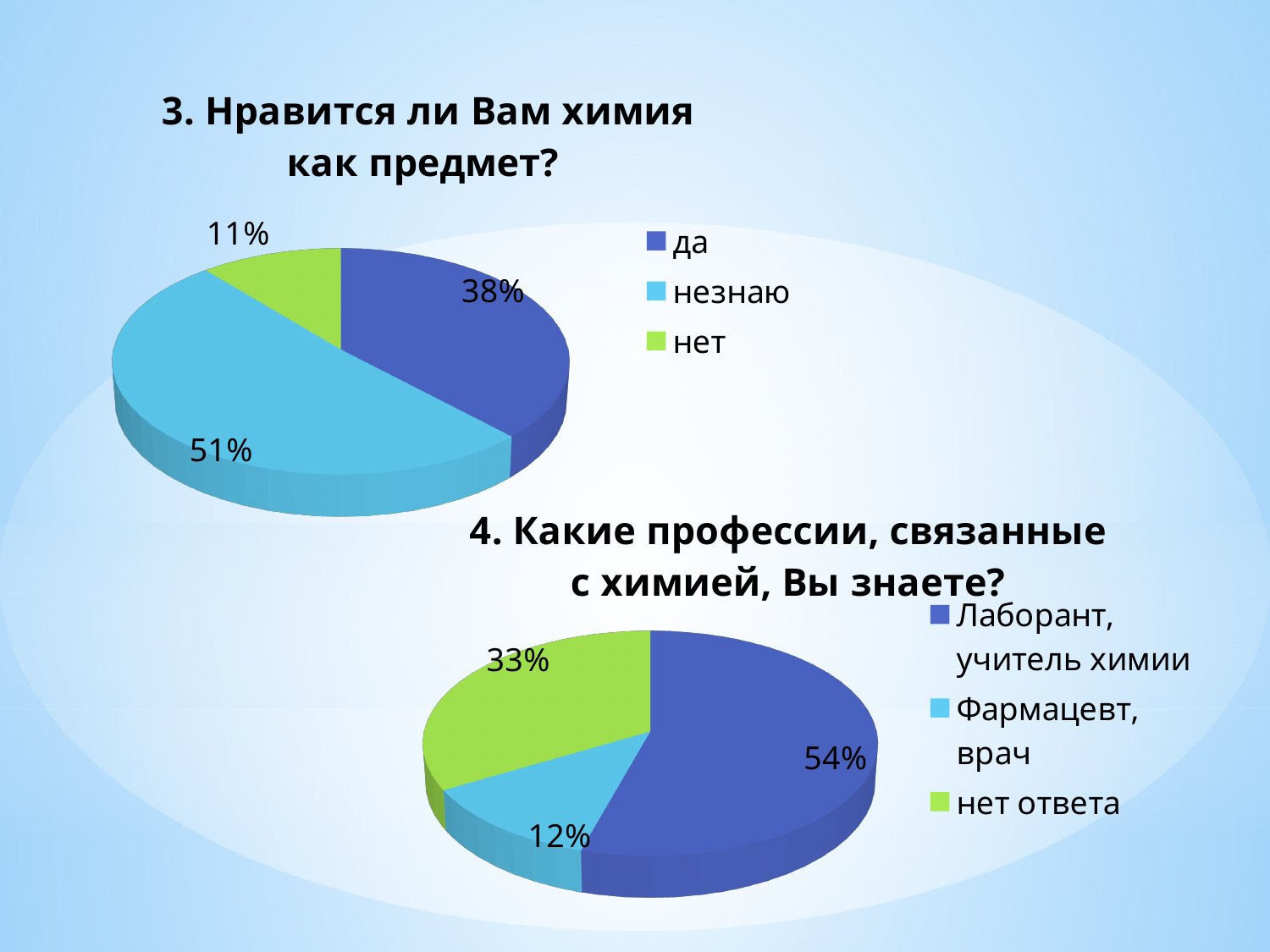
In the chart titled "3. Нравится ли Вам химия как предмет?", how many answer categories are shown in the legend? 3 In the chart titled "4. Какие профессии, связанные с химией, Вы знаете?", what colour is the "нет ответа" slice? Green In the chart titled "4. Какие профессии, связанные с химией, Вы знаете?", which is larger: "нет ответа" or "Фармацевт, врач"? нет ответа In the chart titled "3. Нравится ли Вам химия как предмет?", what share of respondents answered "да"? 38% What type of chart is used for "4. Какие профессии, связанные с химией, Вы знаете?"? Pie chart In the chart titled "4. Какие профессии, связанные с химией, Вы знаете?", what share corresponds to "Фармацевт, врач"? 12% In the chart titled "3. Нравится ли Вам химия как предмет?", what share of respondents answered "незнаю"? 51% In the chart titled "3. Нравится ли Вам химия как предмет?", which answer has the smallest slice? нет In the chart titled "4. Какие профессии, связанные с химией, Вы знаете?", which category has the largest slice? Лаборант, учитель химии In the chart titled "3. Нравится ли Вам химия как предмет?", which answer has the largest slice? незнаю In the chart titled "3. Нравится ли Вам химия как предмет?", what is the difference in percentage points between "незнаю" and "да"? 13 percentage points In the chart titled "4. Какие профессии, связанные с химией, Вы знаете?", what share corresponds to "Лаборант, учитель химии"? 54%